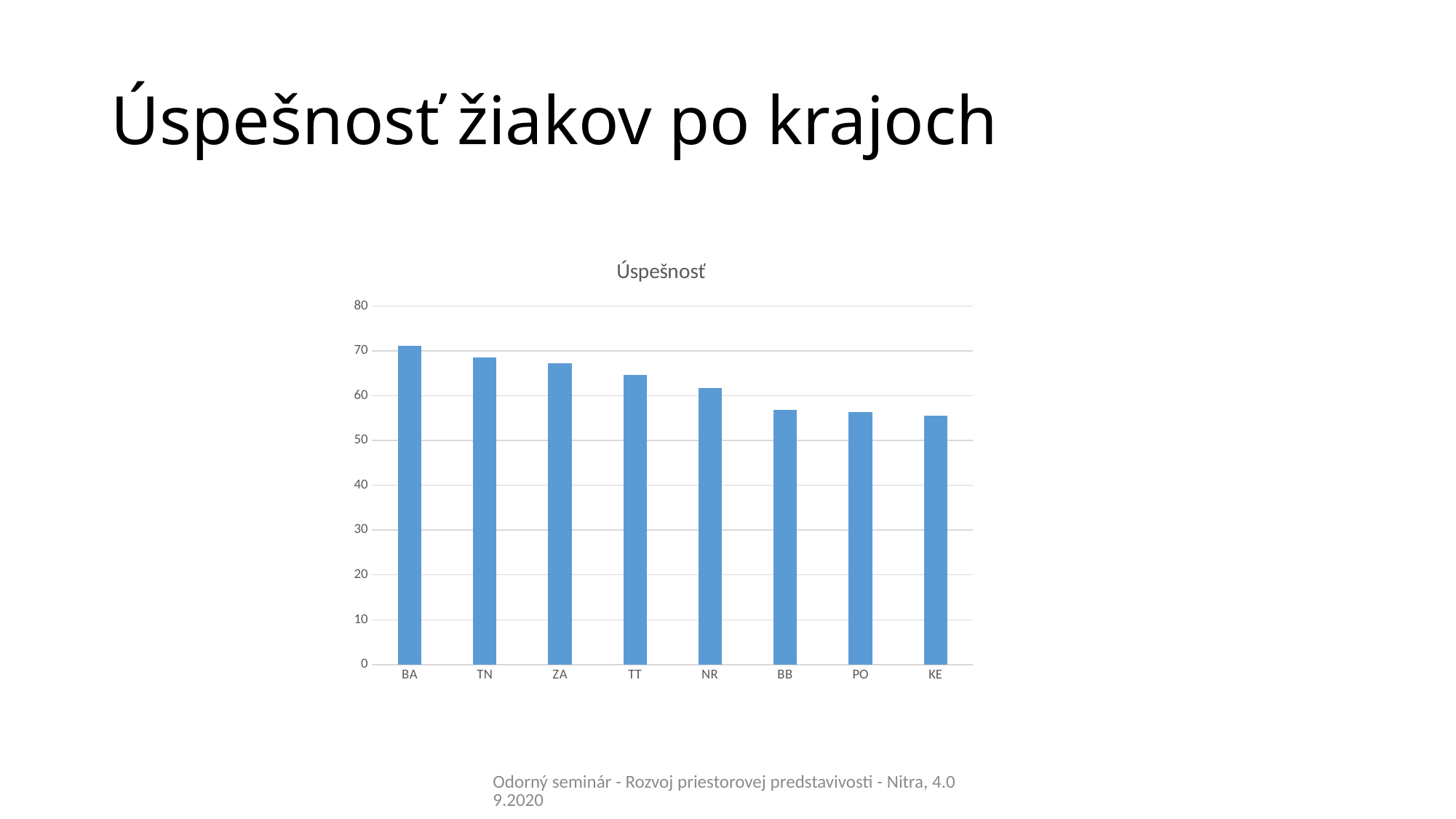
Which has the larger value, TN or BB? TN Is the value for BA greater or less than 60? greater What is the title of the chart? Úspešnosť Which has the larger value, BA or KE? BA Is the value for TN greater or less than 70? less Is the value for BB greater or less than 60? less How many regions (categories) are shown on the x axis of the chart? 8 Which region has the highest value in the chart? BA Do the values rise or fall from left to right along the x axis? fall What kind of chart is shown on the slide? bar chart